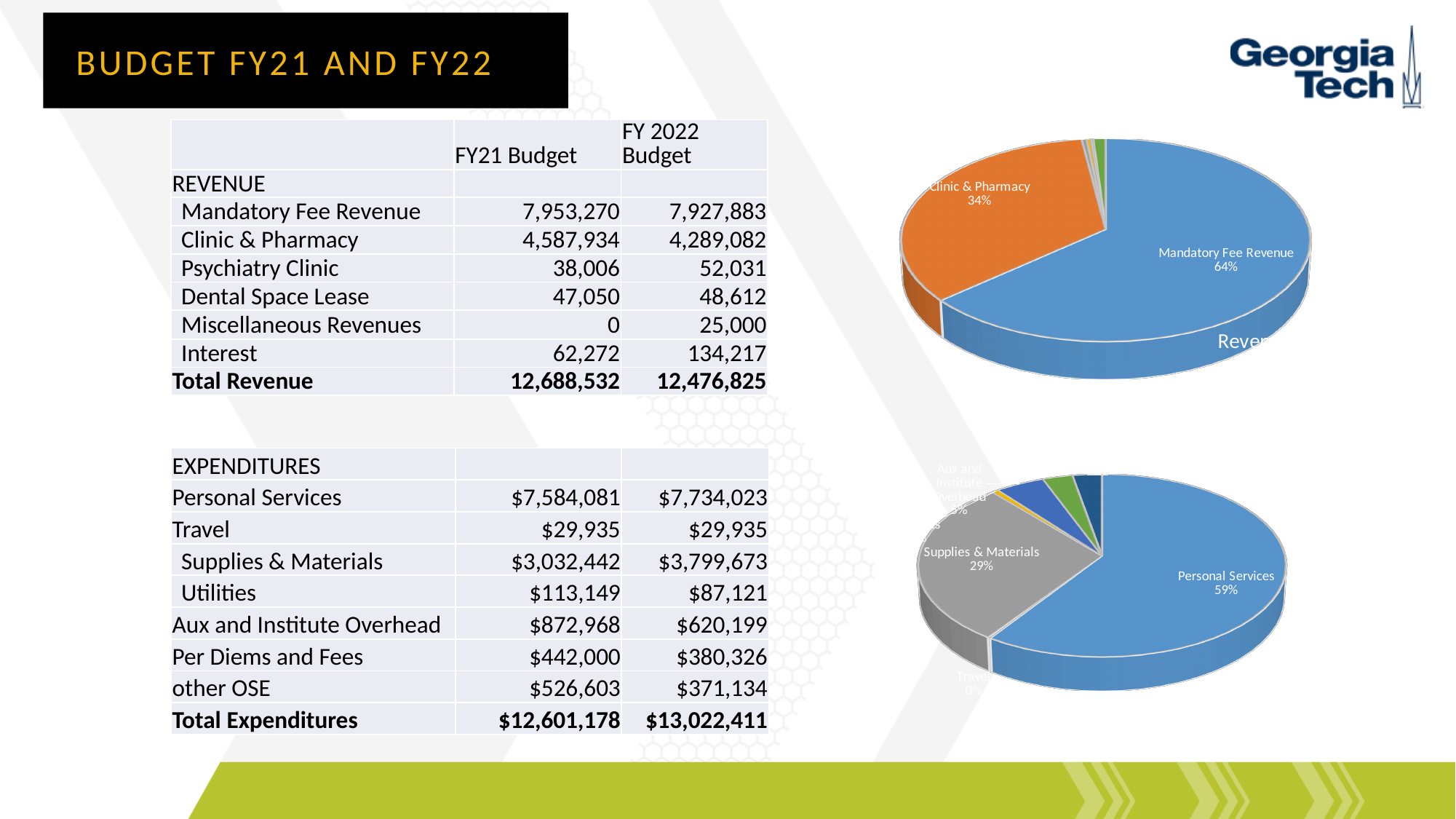
What kind of chart is the bottom chart on the right side of the slide? pie chart What kind of chart is the top chart on the right side of the slide? pie chart How many pie charts are shown on the slide? 2 In the top pie chart, what share does Clinic & Pharmacy have? 34% In the top pie chart, which is larger: Mandatory Fee Revenue or Clinic & Pharmacy? Mandatory Fee Revenue In the bottom pie chart, what share does Supplies & Materials have? 29% In the bottom pie chart, which slice is the largest? Personal Services In the top pie chart, what is the difference in percentage points between Mandatory Fee Revenue and Clinic & Pharmacy? 30 percentage points In the top pie chart, which slice is the largest? Mandatory Fee Revenue In the bottom pie chart, what share is shown for Travel? 0%